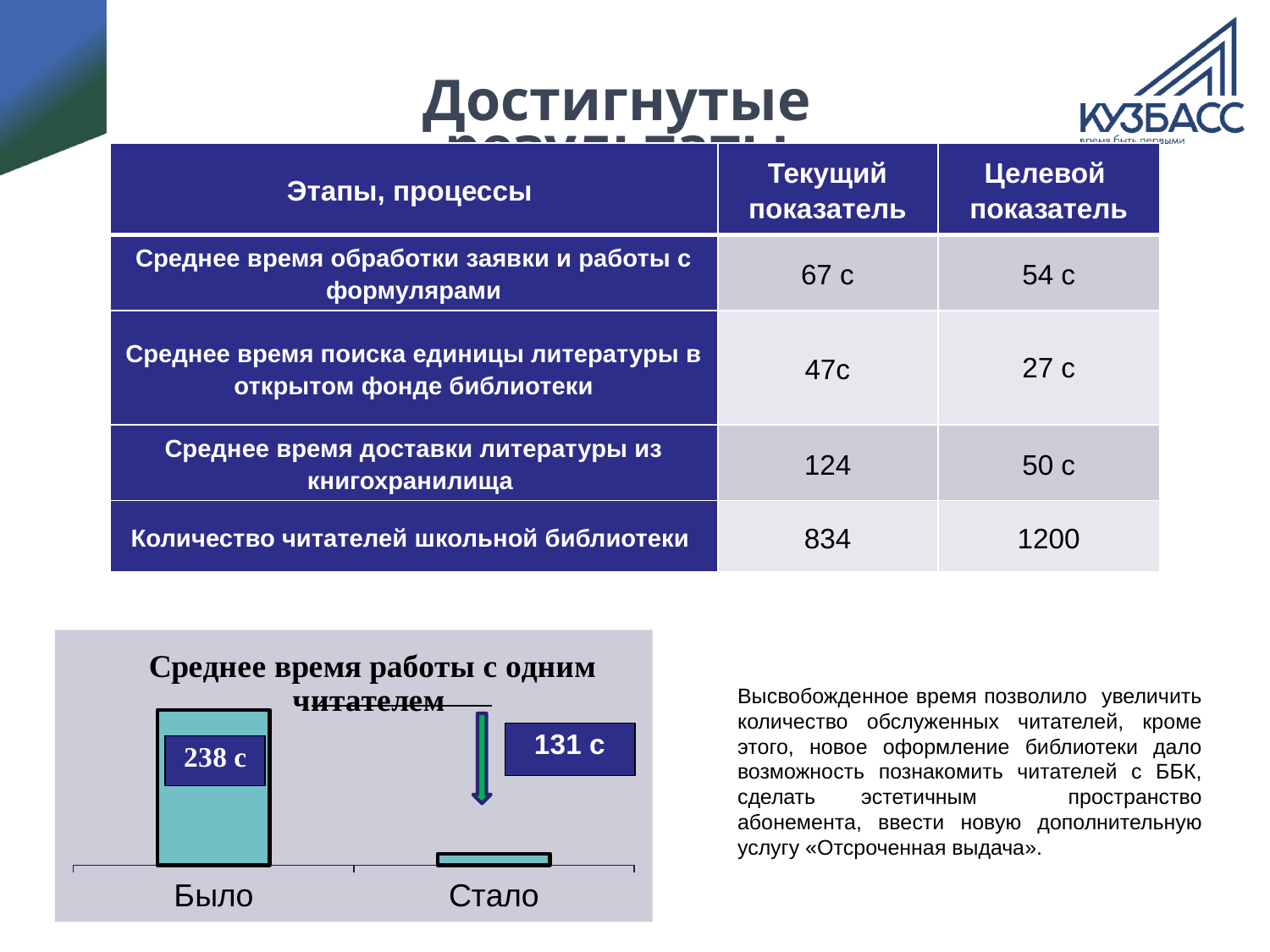
How many categories are shown on the x axis of the chart? 2 Is the bar for "Было" taller or shorter than the bar for "Стало"? taller What are the two category labels on the x axis of the chart? Было, Стало What is the value shown for the "Было" bar in the chart? 238 с Which category has the shortest bar in the chart? Стало Which category has the tallest bar in the chart? Было What type of chart is shown on the slide? bar chart What value is labelled next to the "Стало" bar in the chart? 131 с Do the bar values rise or fall from "Было" to "Стало"? fall What is the title of the chart on the slide? Среднее время работы с одним читателем